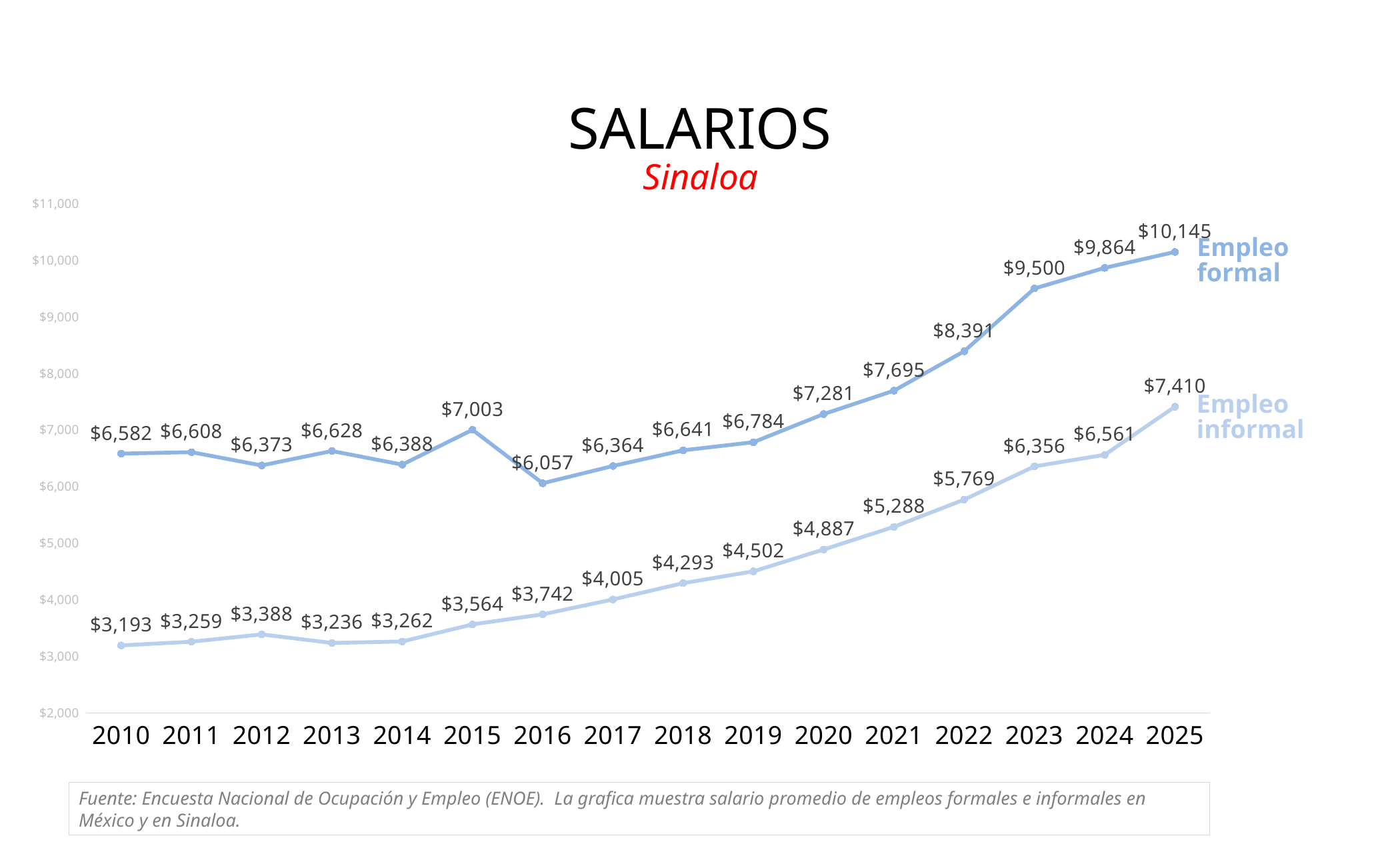
What is the Empleo formal value for 2025? $10,145 What is the Empleo informal value for 2010? $3,193 How many series does the chart show? 2 Does the Empleo informal series rise or fall from 2016 to 2025? Rise In which year is the Empleo informal series highest? 2025 What is the difference between Empleo formal and Empleo informal in 2025? $2,735 In which year is the Empleo formal series lowest? 2016 How many years are shown on the x axis? 16 Which is larger in 2015: Empleo formal or Empleo informal? Empleo formal What is the Empleo formal value for 2016? $6,057 What kind of chart is this? Line chart What is the Empleo informal value for 2020? $4,887